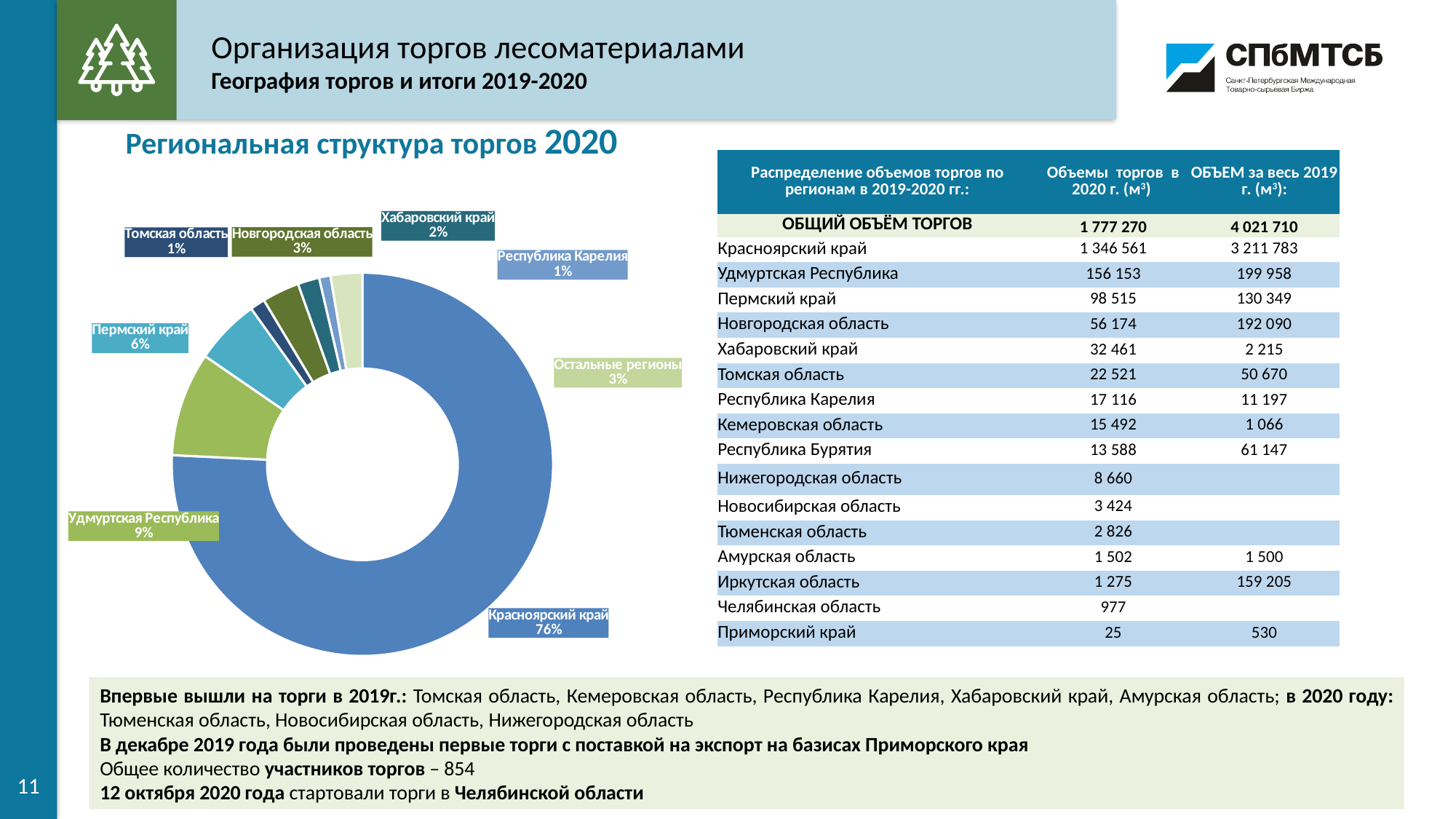
How many slices are labelled in the chart? 8 What kind of chart is shown on the slide? Donut (pie) chart What is the share of Удмуртская Республика in the chart? 9% What is the difference in percentage points between the shares of Красноярский край and Удмуртская Республика? 67 What is the share of Остальные регионы in the chart? 3% Which region has the largest slice in the chart? Красноярский край What is the share of Красноярский край in the chart? 76% What is the share of Хабаровский край in the chart? 2% Which slice is larger, Удмуртская Республика or Пермский край? Удмуртская Республика What is the title of the chart? Региональная структура торгов 2020 What is the share of Пермский край in the chart? 6% What is the share of Новгородская область in the chart? 3%